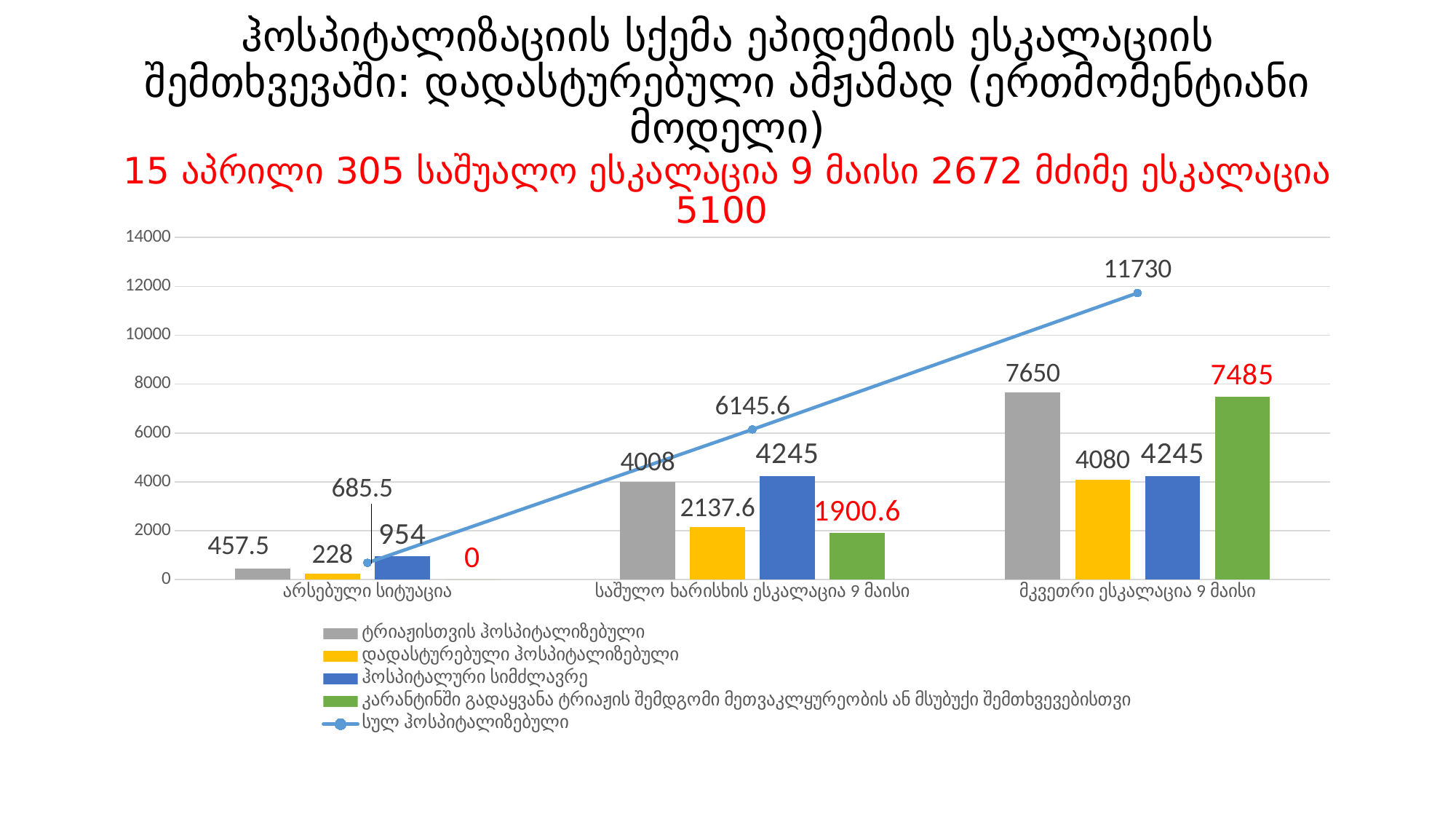
What is the value of ტრიაჟისთვის ჰოსპიტალიზებული (gray bar) for საშუალო ხარისხის ესკალაცია 9 მაისი? 4008 What is the value of the line series სულ ჰოსპიტალიზებული for მკვეთრი ესკალაცია 9 მაისი? 11730 Which category has the lowest value for the green bar (კარანტინში გადაყვანა)? არსებული სიტუაცია What is the difference between the ჰოსპიტალური სიმძლავრე (blue bar) value and the ტრიაჟისთვის ჰოსპიტალიზებული (gray bar) value for მკვეთრი ესკალაცია 9 მაისი? 3405 What is the value of დადასტურებული ჰოსპიტალიზებული (yellow bar) for არსებული სიტუაცია? 228 What kind of chart is shown on the slide? Combined bar and line chart How many series does the legend list? 5 Does the line series სულ ჰოსპიტალიზებული rise or fall from left to right across the categories? Rises How many categories are shown on the x axis? 3 Which category has the highest value for the line series სულ ჰოსპიტალიზებული? მკვეთრი ესკალაცია 9 მაისი What is the value of the green bar (კარანტინში გადაყვანა) for მკვეთრი ესკალაცია 9 მაისი? 7485 For საშუალო ხარისხის ესკალაცია 9 მაისი, which is larger: the blue bar (ჰოსპიტალური სიმძლავრე) or the yellow bar (დადასტურებული ჰოსპიტალიზებული)? ჰოსპიტალური სიმძლავრე (blue bar)